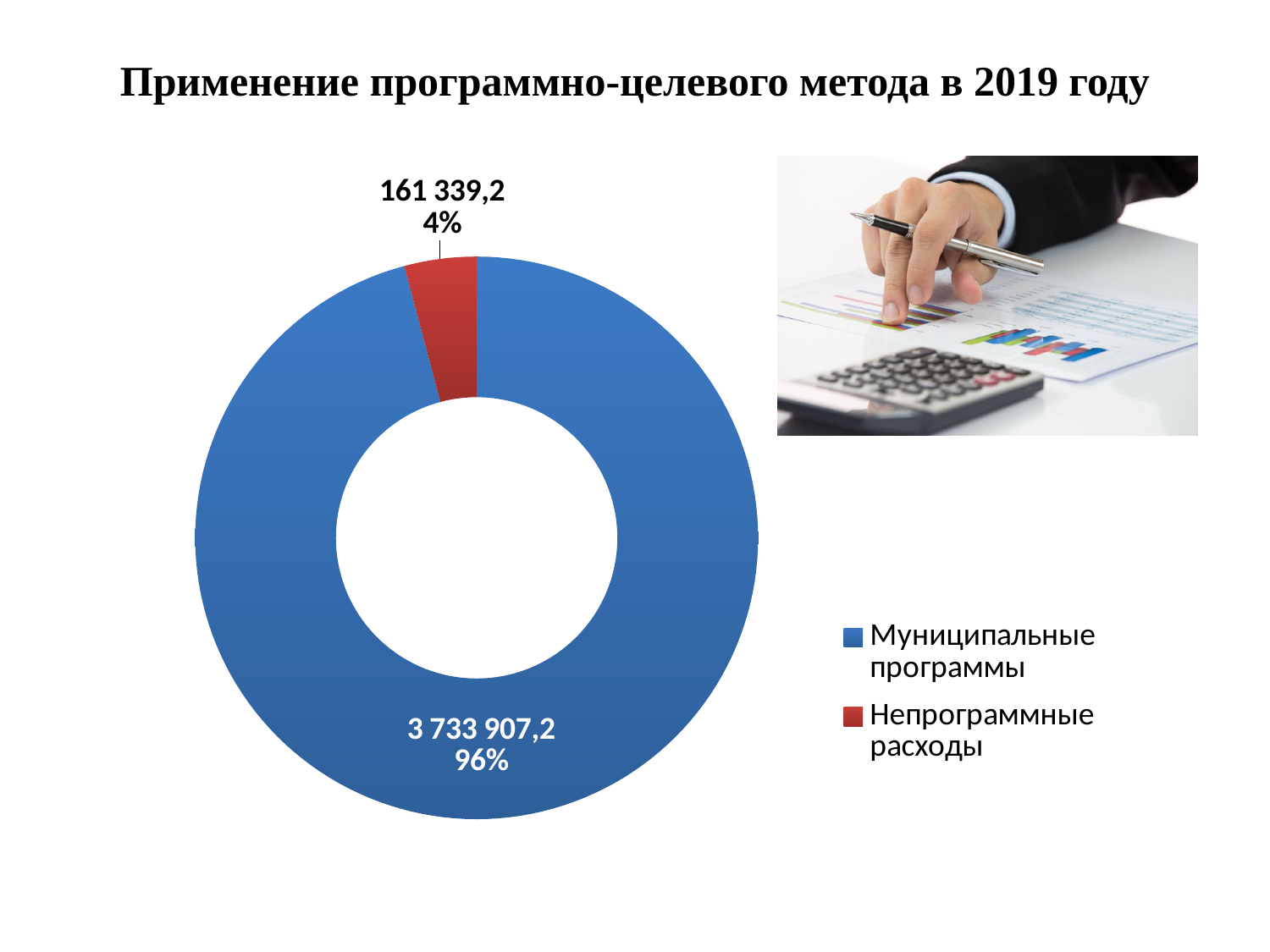
Which category has the largest value? Муниципальные программы How many categories does the chart show? 2 What value is shown for Муниципальные программы? 3 733 907,2 Which category has the smallest value? Непрограммные расходы What kind of chart is shown on the slide? doughnut chart What is the total of the two values shown on the chart? 3 895 246,4 What colour is the slice for Непрограммные расходы? red What share of the chart does Муниципальные программы take? 96% What share of the chart does Непрограммные расходы take? 4% Which is larger: Муниципальные программы or Непрограммные расходы? Муниципальные программы What value is shown for Непрограммные расходы? 161 339,2 What is the difference between the values for Муниципальные программы and Непрограммные расходы? 3 572 568,0